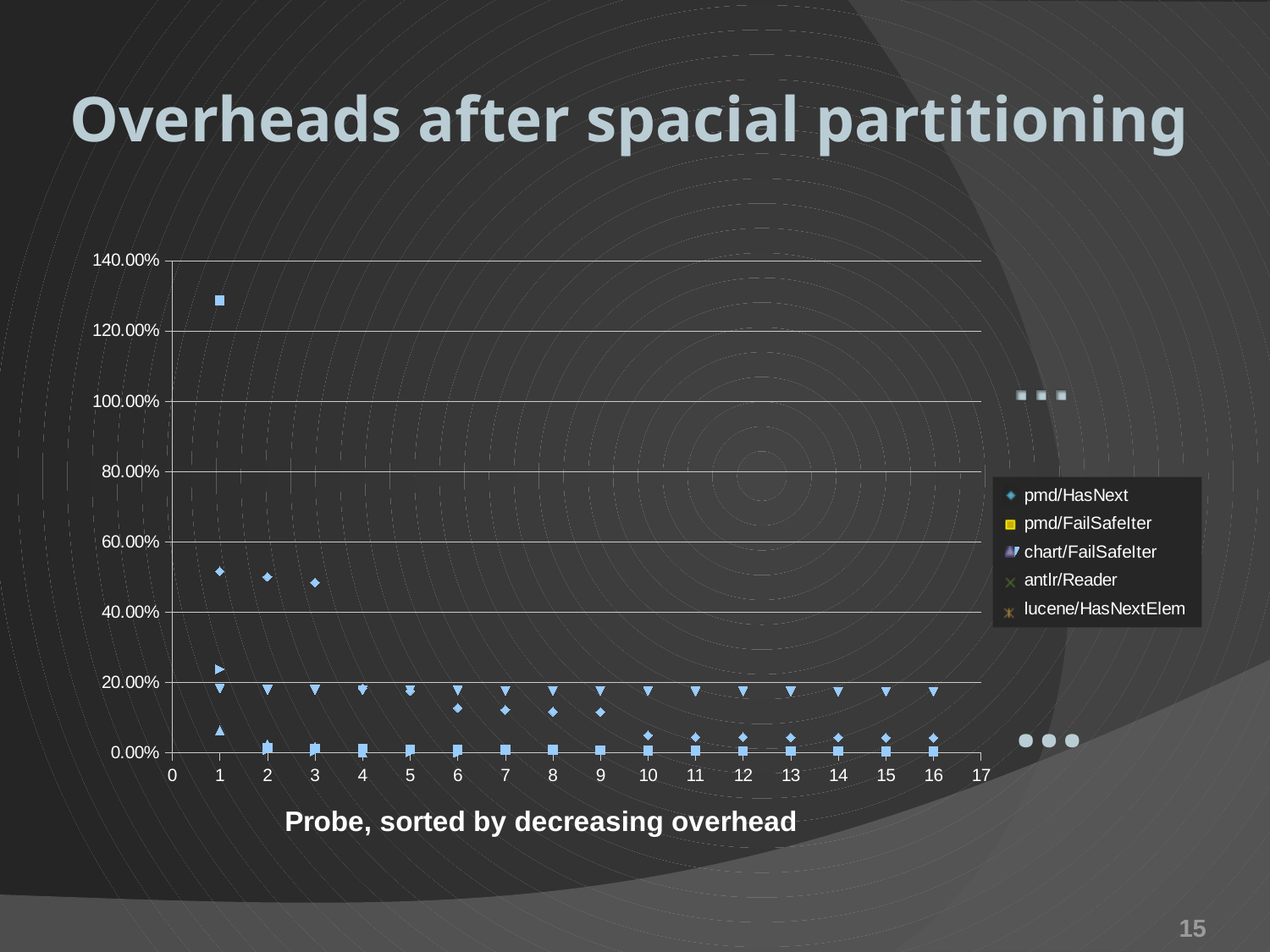
Is the highest plotted point on the chart (at probe 1) greater or less than 120%? greater What is the highest value shown on the y axis? 140.00% What kind of chart is shown on the slide? scatter chart What is the title of the chart's x axis? Probe, sorted by decreasing overhead How many probes (x positions) have data points plotted on the chart? 16 What is the title of the slide? Overheads after spacial partitioning Is the highest plotted point on the chart (at probe 1) greater or less than 140%? less Is the diamond-marker point at probe 16 greater or less than 20%? less Do the overhead values generally rise or fall as the probe number increases along the x axis? fall How many series does the legend list? 5